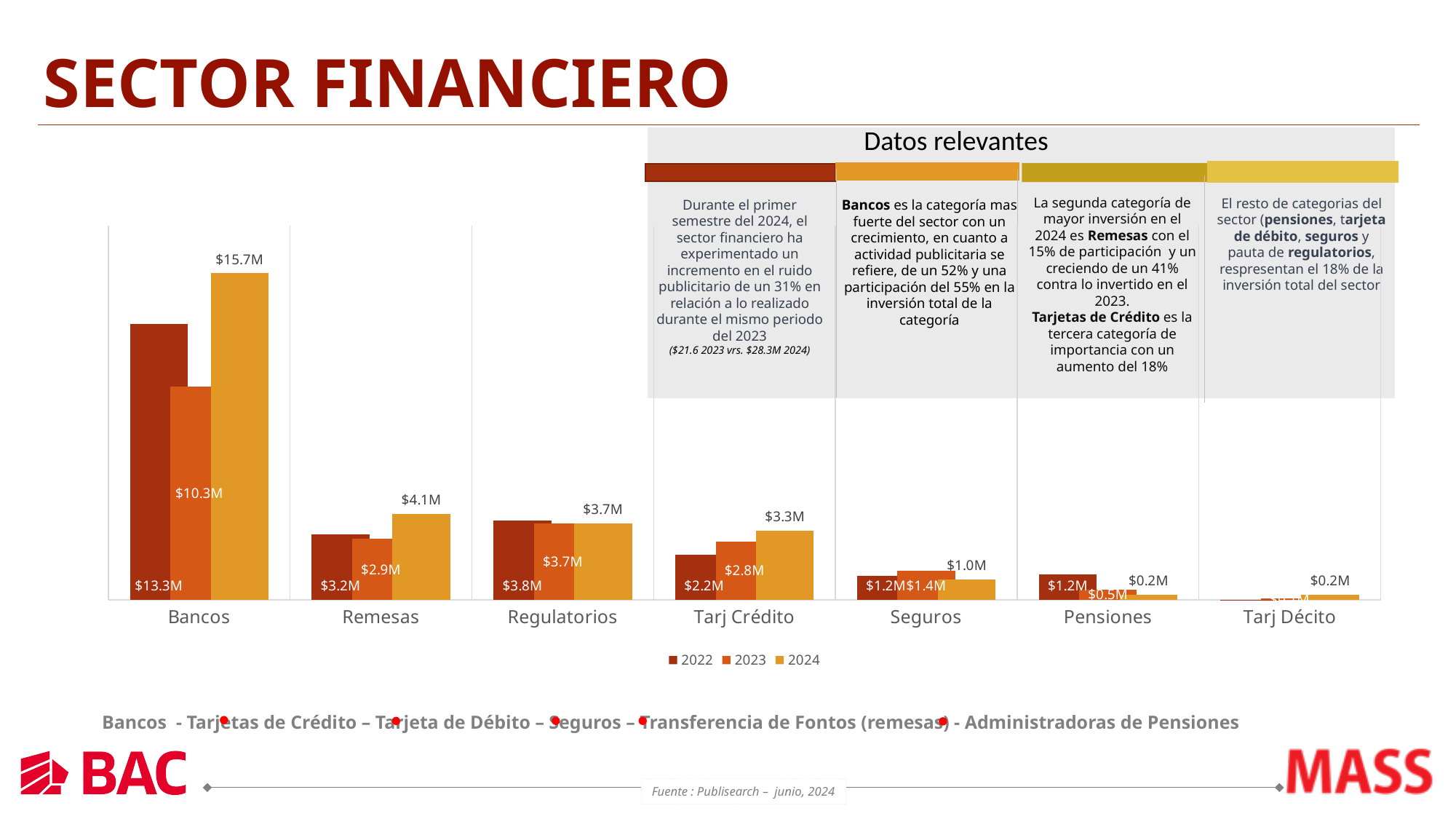
Which is larger for Seguros, the 2023 value or the 2024 value? 2023 Which category has the lowest 2022 value among Bancos, Remesas, Regulatorios, Tarj Crédito, Seguros and Pensiones? Seguros and Pensiones (tied at $1.2M) Which category has the highest 2024 value? Bancos What is the difference between the 2024 and 2023 values for Bancos? $5.4M How many series does the legend list? 3 Which series is shown in the darkest red colour in the legend? 2022 What is the 2023 value for Remesas? $2.9M What is the difference between the 2024 values for Remesas and Tarj Crédito? $0.8M What is the 2022 value for Tarj Crédito? $2.2M What kind of chart is shown on the slide? bar chart What is the 2024 value for Bancos? $15.7M How many categories are shown on the x axis of the chart? 7